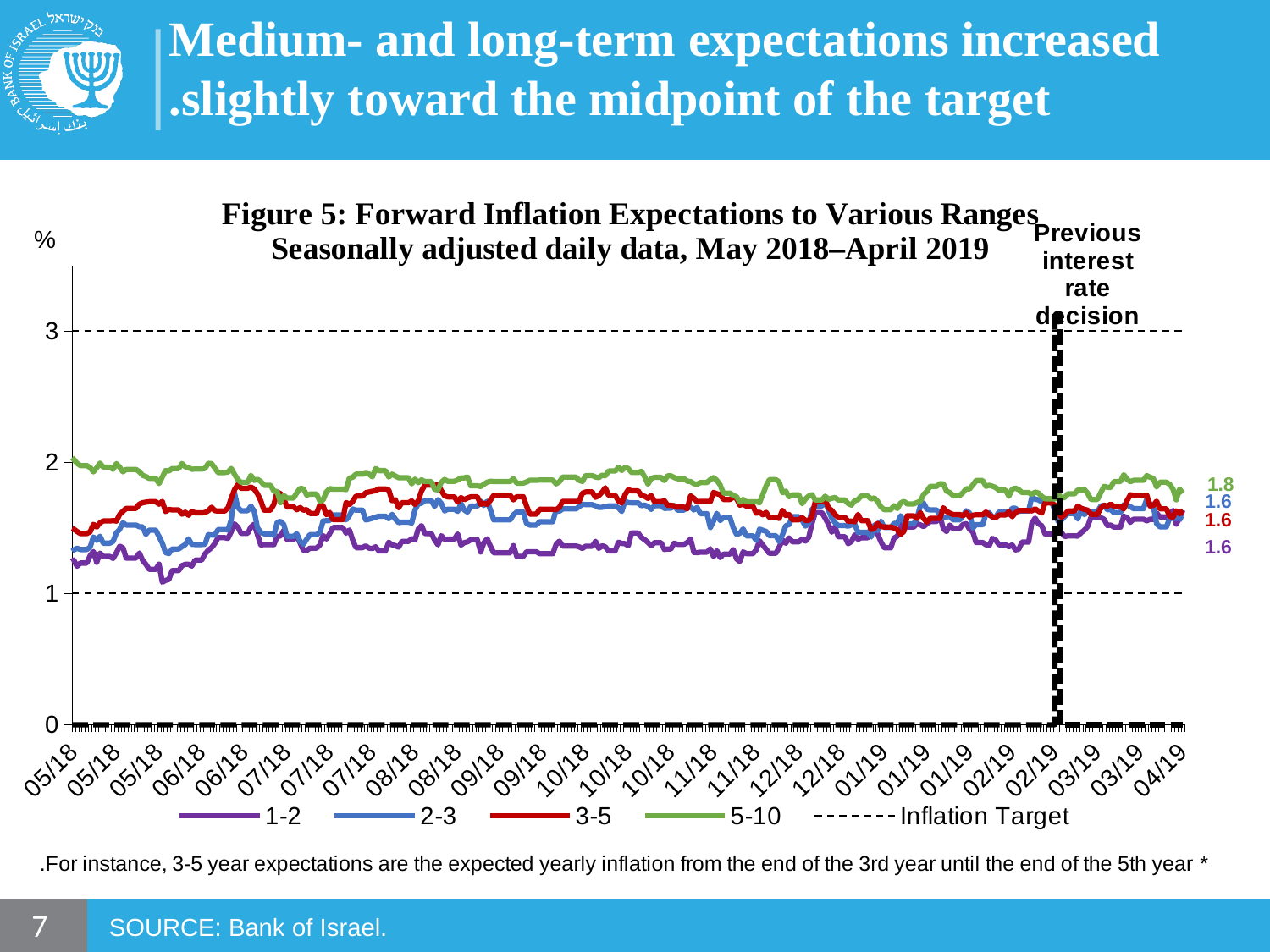
Is the value of the 1-2 series in 05/18 greater or less than 2? less What is the latest value shown for the 1-2 year expectations series? 1.6 Does the 1-2 series rise or fall overall from May 2018 to April 2019? rise What is the latest value shown for the 5-10 year expectations series? 1.8 At what levels are the dashed Inflation Target lines drawn? 1 and 3 What is the difference between the latest values of the 5-10 series and the 1-2 series? 0.2 What is the latest value shown for the 3-5 year expectations series? 1.6 At the end of the period, which is larger: the 5-10 series or the 3-5 series? 5-10 What kind of chart is Figure 5? line chart Which series has the highest value at the end of the period (April 2019)? 5-10 Is the value of the 5-10 series in 05/18 greater or less than 1? greater How many entries does the legend of Figure 5 list? 5